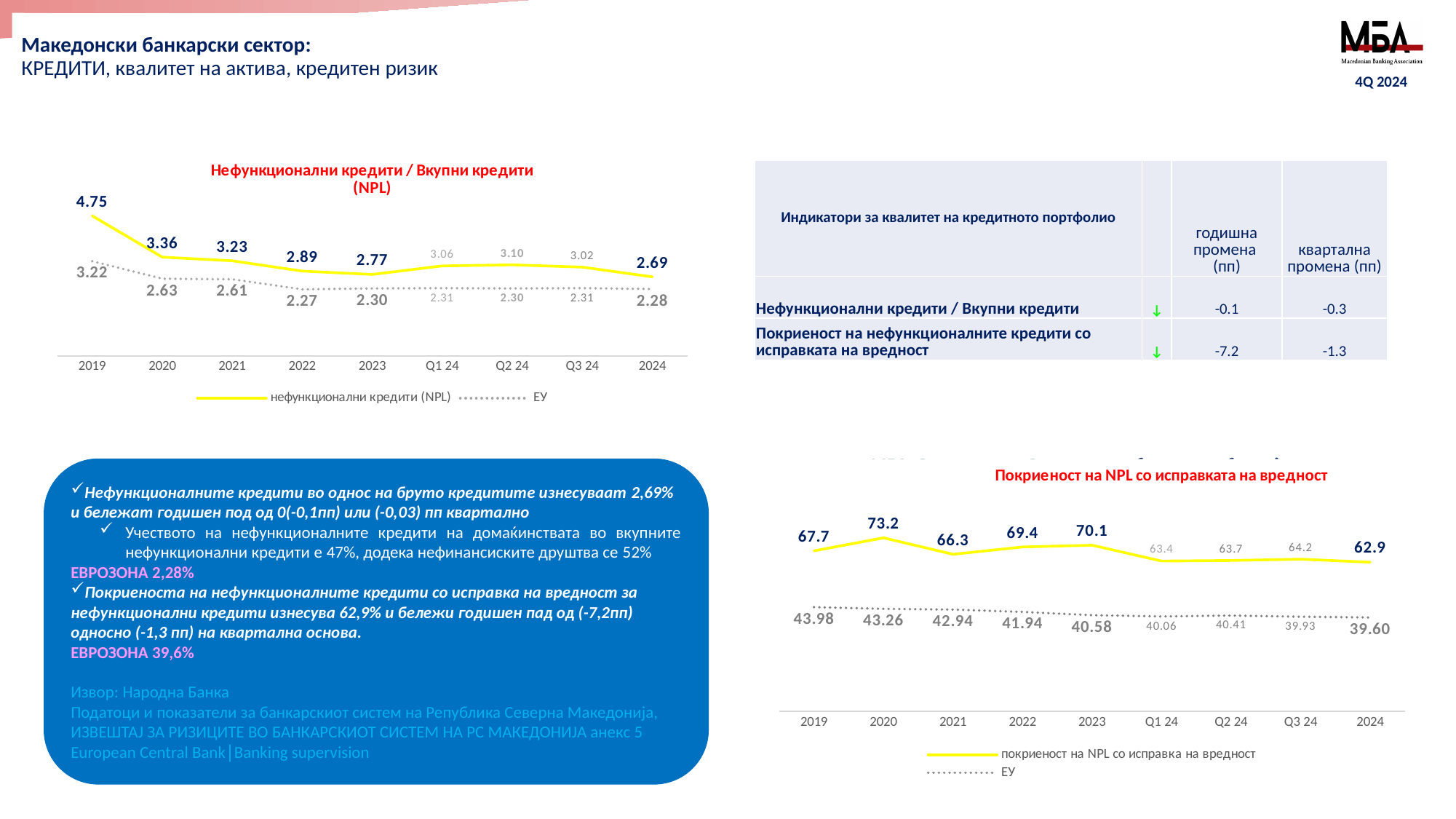
In the chart titled 'Нефункционални кредити / Вкупни кредити (NPL)', what is the ЕУ value for 2024? 2.28 In the chart titled 'Нефункционални кредити / Вкупни кредити (NPL)', what is the difference between the NPL value and the ЕУ value for 2024? 0.41 In the chart titled 'Покриеност на NPL со исправката на вредност', is the coverage value for 2023 larger or smaller than the value for 2024? larger In the chart titled 'Покриеност на NPL со исправката на вредност', does the ЕУ series rise or fall from 2019 to 2024? fall In the chart titled 'Покриеност на NPL со исправката на вредност', what is the ЕУ value for 2019? 43.98 In the chart titled 'Нефункционални кредити / Вкупни кредити (NPL)', what is the NPL value for 2019? 4.75 In the chart titled 'Нефункционални кредити / Вкупни кредити (NPL)', how many series does the legend list? 2 In the chart titled 'Покриеност на NPL со исправката на вредност', what is the coverage value for 2020? 73.2 In the chart titled 'Нефункционални кредити / Вкупни кредити (NPL)', which year or quarter has the highest NPL value? 2019 In the chart titled 'Нефункционални кредити / Вкупни кредити (NPL)', how many points are plotted along the x axis? 9 What kind of chart is the chart titled 'Покриеност на NPL со исправката на вредност'? line chart In the chart titled 'Покриеност на NPL со исправката на вредност', which year or quarter has the lowest coverage value? 2024